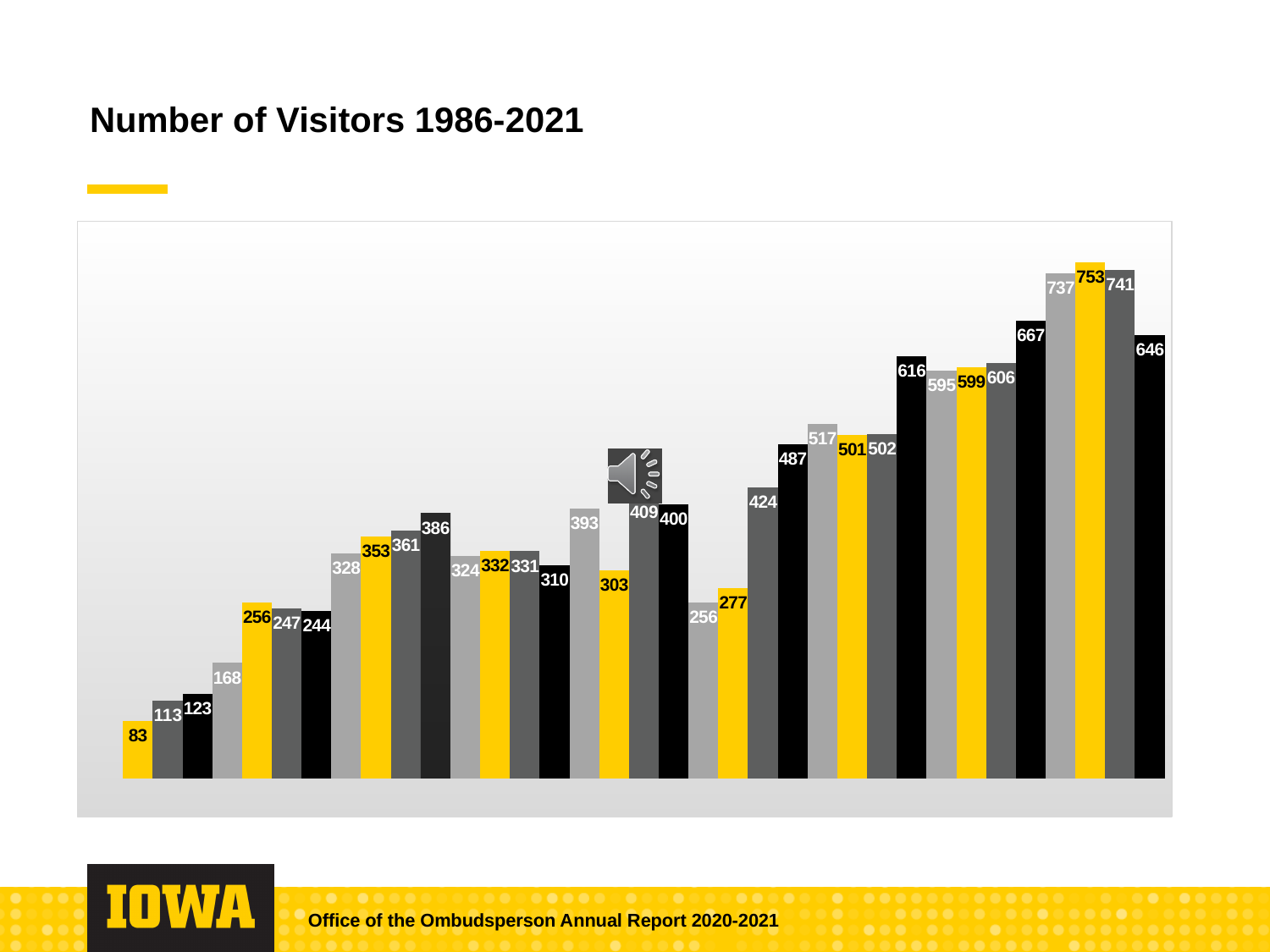
What is the title of the chart? Number of Visitors 1986-2021 Which is larger, the first bar or the last bar? the last bar What is the value of the first (leftmost) bar in the chart? 83 What is the difference between the tallest bar (753) and the shortest bar (83)? 670 What is the lowest value shown on any bar in the chart? 83 What colour is the tallest bar (753) in the chart? yellow What is the difference between the tallest bar (753) and the last bar (646)? 107 What is the difference between the second bar (113) and the first bar (83)? 30 Overall, do the values rise or fall from left to right across the chart? rise What is the highest value shown on any bar in the chart? 753 What is the value of the last (rightmost) bar in the chart? 646 What type of chart is shown on the slide? bar chart